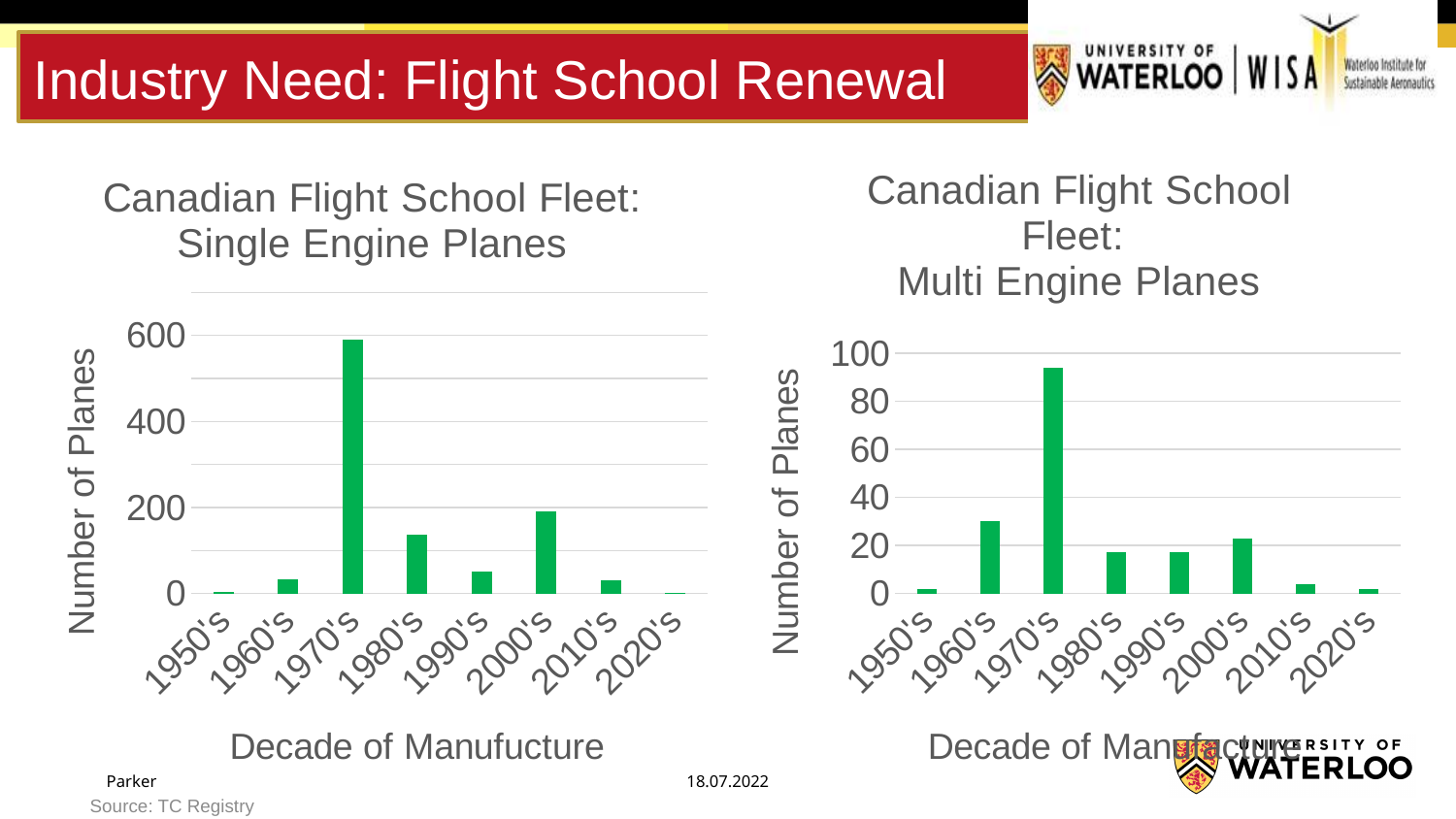
In the Multi Engine Planes chart, which is larger, the value for the 1960's or the value for the 2000's? 1960's In the Multi Engine Planes chart, what is the label on the y axis? Number of Planes In the Single Engine Planes chart, how many decades are shown on the x axis? 8 In the Multi Engine Planes chart, is the value for the 1970's greater or less than 80? greater In the Single Engine Planes chart, which is larger, the value for the 2000's or the value for the 1990's? 2000's In the Single Engine Planes chart, what kind of chart is shown? bar chart In the Single Engine Planes chart, is the value for the 1980's greater or less than 200? less In the Single Engine Planes chart, what is the label on the x axis? Decade of Manufucture In the Single Engine Planes chart, is the value for the 1970's greater or less than 400? greater In the Single Engine Planes chart, which decade has the highest number of planes? 1970's In the Multi Engine Planes chart, which decade has the highest number of planes? 1970's